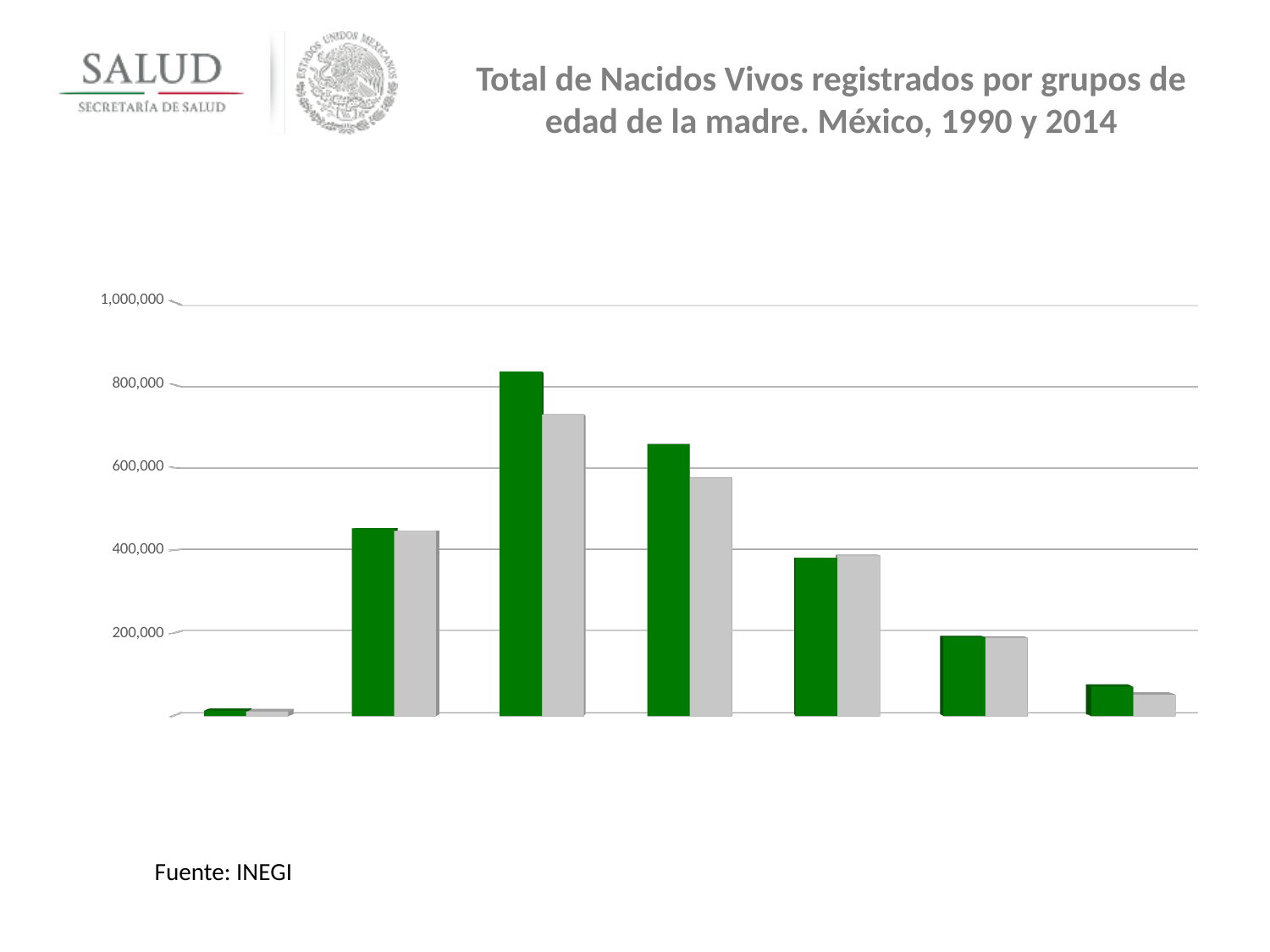
What kind of chart is shown on the slide? Bar chart Is the green bar in the seventh group from the left greater or less than 200,000? less Is the grey bar in the third group from the left greater or less than 800,000? less Which group of bars, counting from the left, has the lowest values? The first group In the third group from the left, which bar is taller, the green one or the grey one? The green one Which group of bars, counting from the left, has the highest values? The third group Is the green bar in the fourth group from the left greater or less than 600,000? greater How many groups of bars are plotted along the x axis? 7 What is the title of the chart? Total de Nacidos Vivos registrados por grupos de edad de la madre. México, 1990 y 2014 What two colours are used for the bars in the chart? Green and grey